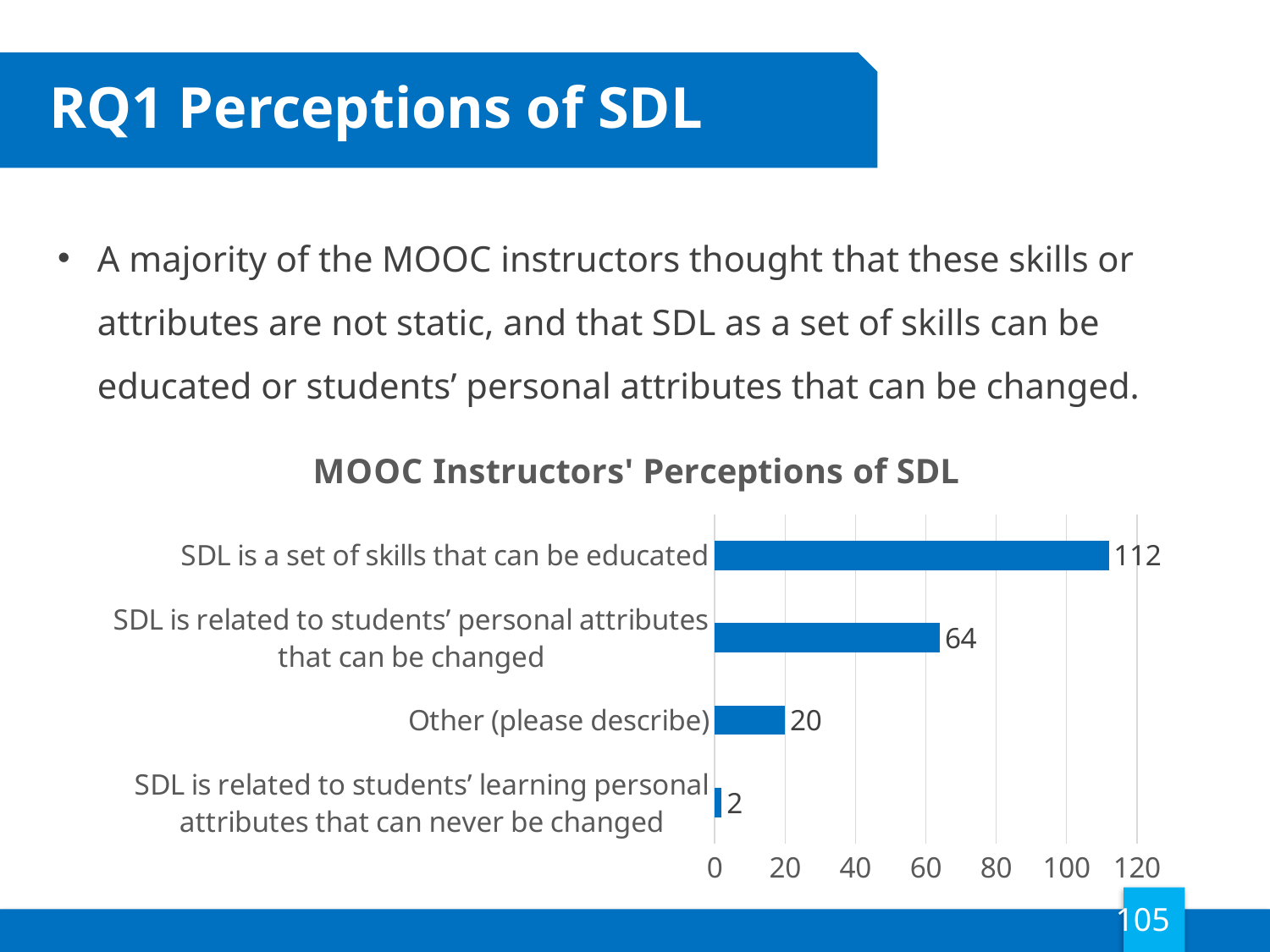
How many categories are shown in the chart? 4 Which category has the highest value? SDL is a set of skills that can be educated What is the value for "SDL is related to students' learning personal attributes that can never be changed"? 2 What is the title of the chart? MOOC Instructors' Perceptions of SDL Which category has the lowest value? SDL is related to students' learning personal attributes that can never be changed What is the difference between the values for "SDL is a set of skills that can be educated" and "SDL is related to students' personal attributes that can be changed"? 48 Is the value for "SDL is related to students' personal attributes that can be changed" greater or less than 80? less Which is larger: the value for "Other (please describe)" or the value for "SDL is related to students' learning personal attributes that can never be changed"? Other (please describe) What is the value for "SDL is a set of skills that can be educated"? 112 What is the value for "Other (please describe)"? 20 What is the value for "SDL is related to students' personal attributes that can be changed"? 64 What kind of chart is shown on the slide? bar chart